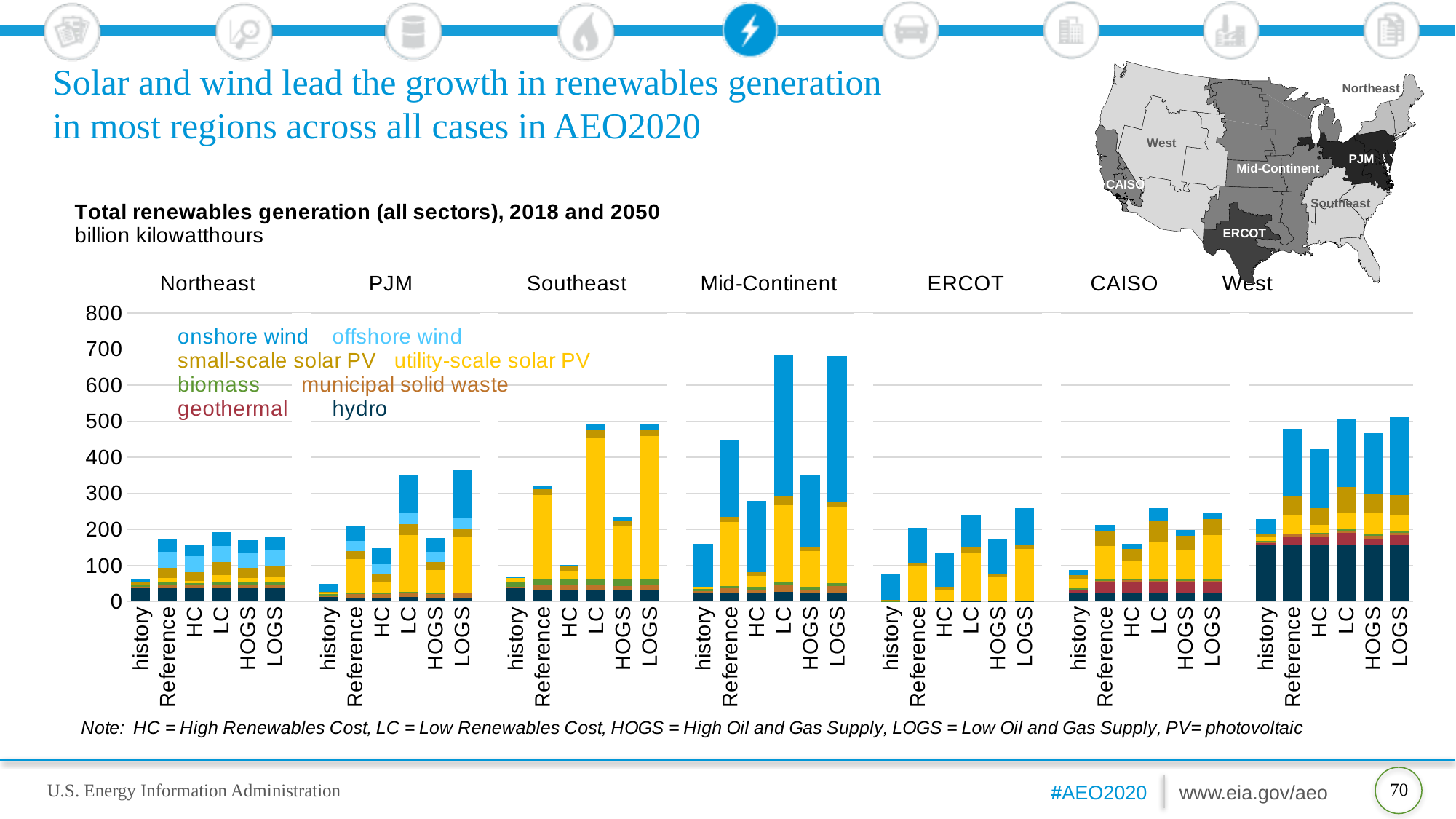
How many bars are plotted in the Northeast panel of the chart? 6 In the Mid-Continent panel, is the total for the LC case greater or less than 600 billion kilowatthours? greater What unit is the chart's y axis measured in? billion kilowatthours In the Northeast panel, is the total for the history bar greater or less than 100 billion kilowatthours? less In the Mid-Continent panel, which is larger, the Reference case total or the HC case total? Reference What kind of chart is shown on the slide? Stacked bar chart Which is larger, the HC case total in the West panel or the HC case total in the ERCOT panel? West How many regional panels does the chart contain? 7 In the West panel, is the total for the Reference case greater or less than 400 billion kilowatthours? greater In the Mid-Continent panel, which bar has the lowest total? history How many series does the chart legend list? 8